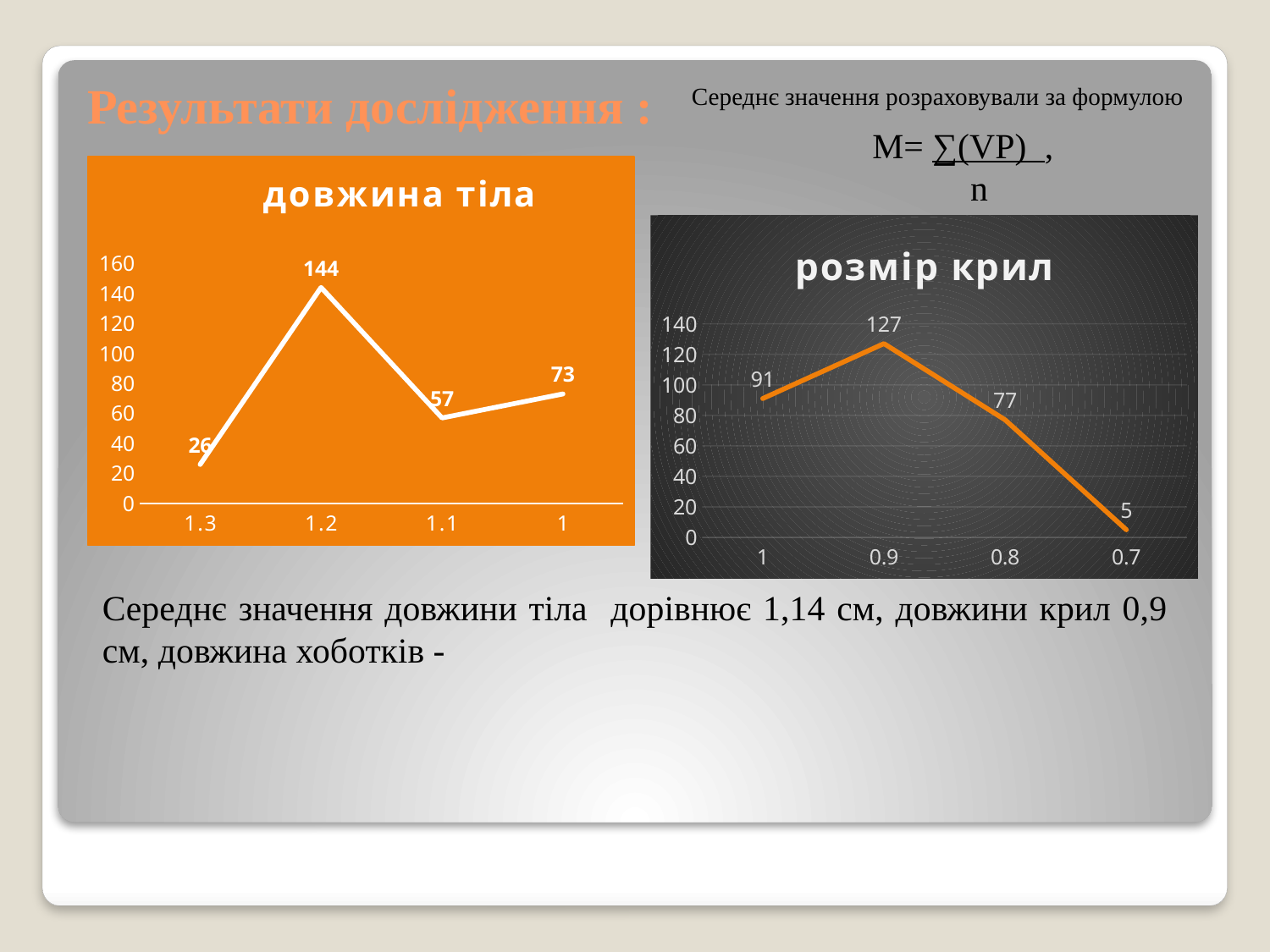
In the "розмір крил" chart, do the values rise or fall from x = 0.9 to x = 0.7? fall In the "довжина тіла" chart, which x-axis category has the lowest value? 1.3 In the "розмір крил" chart, which is larger: the value at 1 or the value at 0.8? 1 In the "довжина тіла" chart, how many data points are plotted? 4 In the "довжина тіла" chart, what is the difference between the values at 1.2 and 1.1? 87 In the "розмір крил" chart, what is the difference between the values at 0.9 and 0.8? 50 In the "довжина тіла" chart, what is the value at x = 1.2? 144 In the "розмір крил" chart, what is the value at x = 0.7? 5 In the "довжина тіла" chart, what is the value at x = 1.3? 26 In the "розмір крил" chart, which x-axis category has the highest value? 0.9 In the "розмір крил" chart, what is the value at x = 0.9? 127 What type of chart is the "довжина тіла" chart? line chart